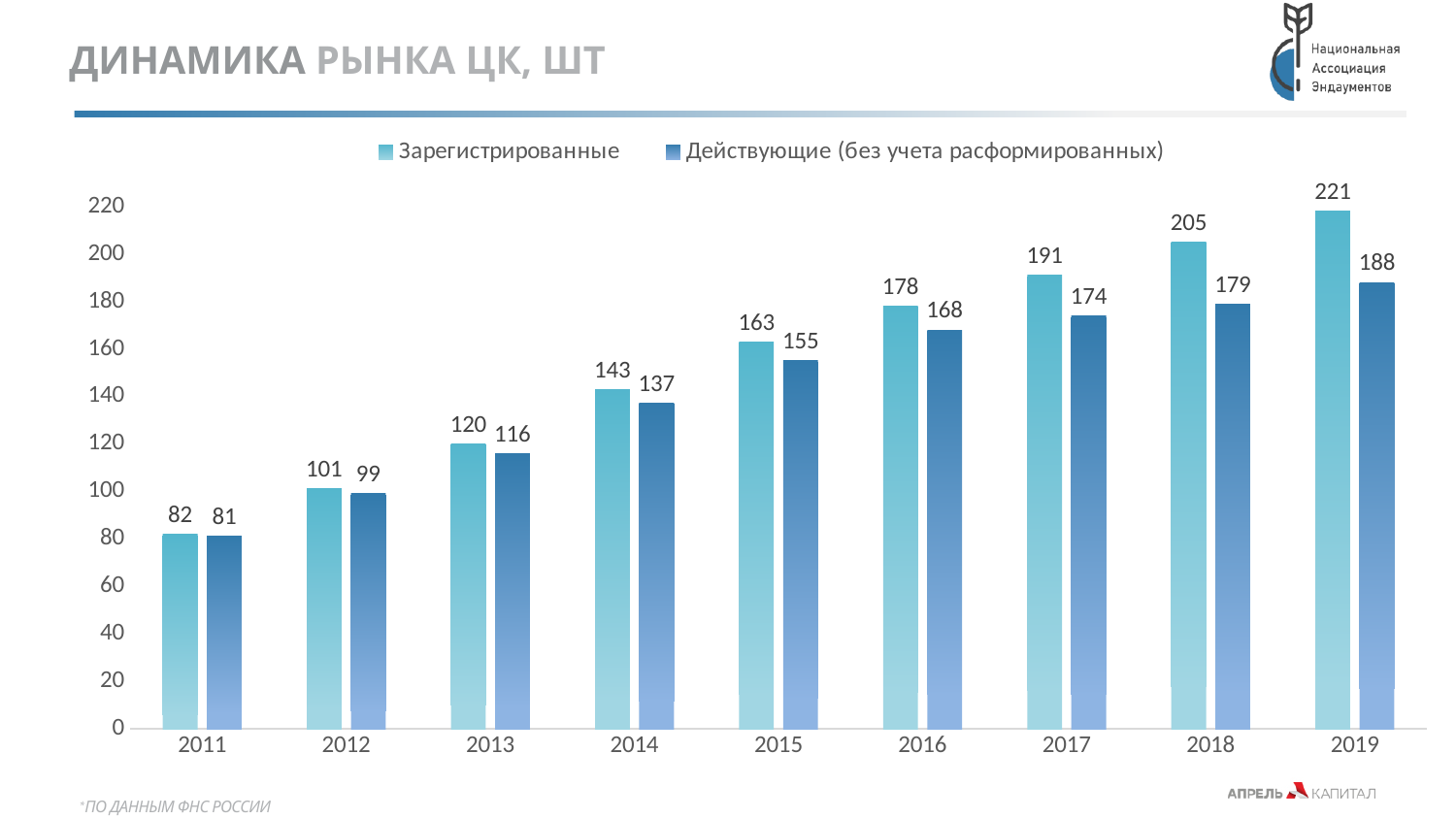
What is the difference between the Зарегистрированные values for 2018 and 2017? 14 What is the value for Действующие (без учета расформированных) in 2018? 179 Which is larger: Зарегистрированные in 2014 or Действующие (без учета расформированных) in 2015? Действующие (без учета расформированных) in 2015 Which year has the lowest value for Действующие (без учета расформированных)? 2011 What is the difference between Зарегистрированные and Действующие (без учета расформированных) in 2019? 33 How many years are shown on the x axis? 9 Which year has the highest value for Зарегистрированные? 2019 Is the value for Действующие (без учета расформированных) in 2016 greater or less than 160? greater Do the Зарегистрированные values rise or fall from 2011 to 2019? Rise What kind of chart is shown on the slide? Bar chart What is the value for Зарегистрированные in 2015? 163 How many series does the legend list? 2